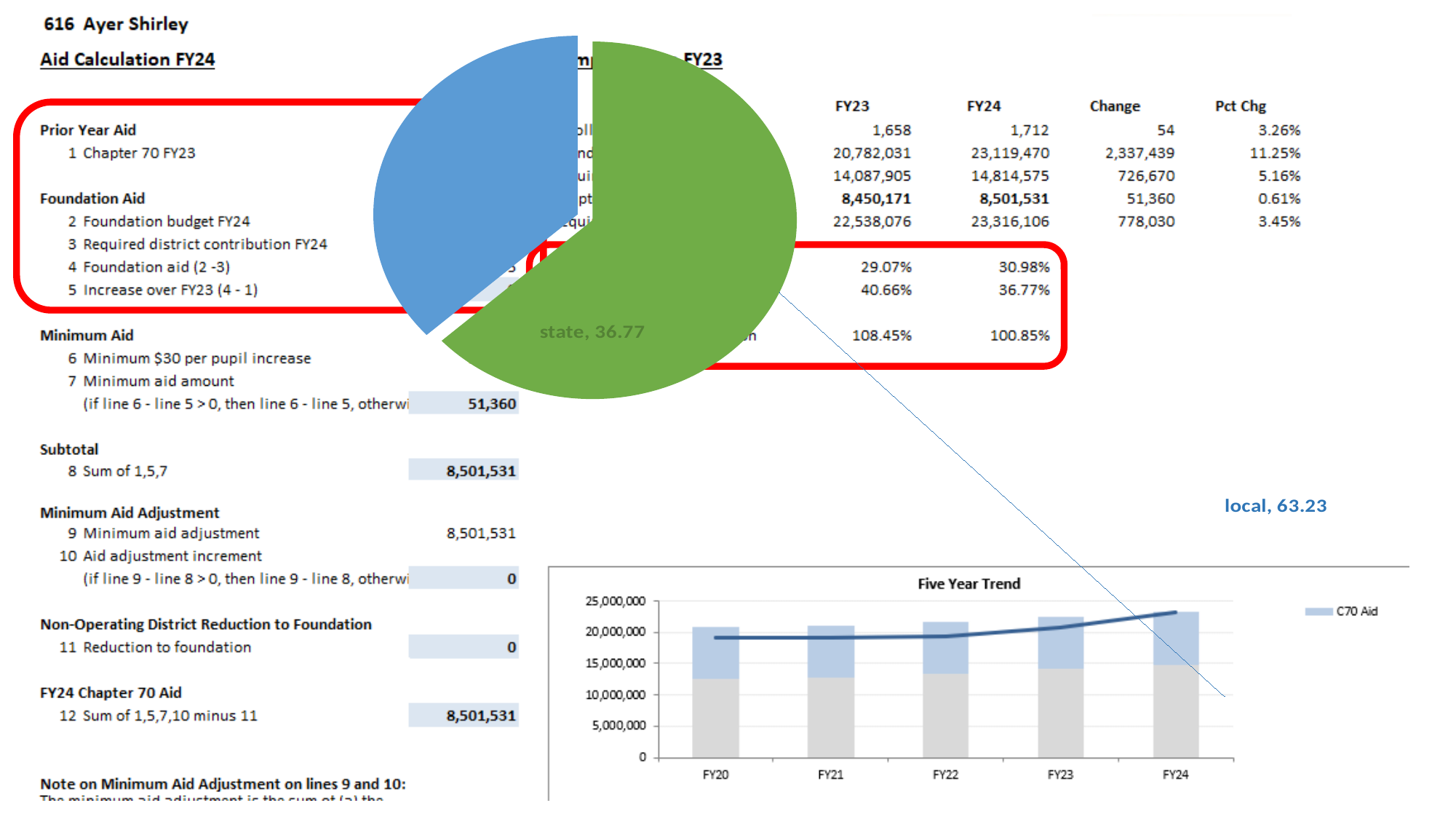
In the 'Five Year Trend' chart, is the total height of the FY24 bar greater or less than 20,000,000? greater In the 'Five Year Trend' chart, which fiscal year has the tallest bar? FY24 In the pie chart, what is the value shown for the 'local' slice? 63.23 In the pie chart, which slice is larger, 'state' or 'local'? local What type of chart is the chart in the upper middle of the slide with the 'state' and 'local' labels? pie chart In the 'Five Year Trend' chart, do the bar heights generally rise or fall from FY20 to FY24? rise What type of chart is the 'Five Year Trend' chart? bar chart How many fiscal years are shown on the x axis of the 'Five Year Trend' chart? 5 How many slices does the pie chart have? 2 In the pie chart, what is the value shown for the 'state' slice? 36.77 What is the title of the chart in the lower right of the slide? Five Year Trend In the 'Five Year Trend' chart, is the total height of the FY22 bar greater or less than 25,000,000? less